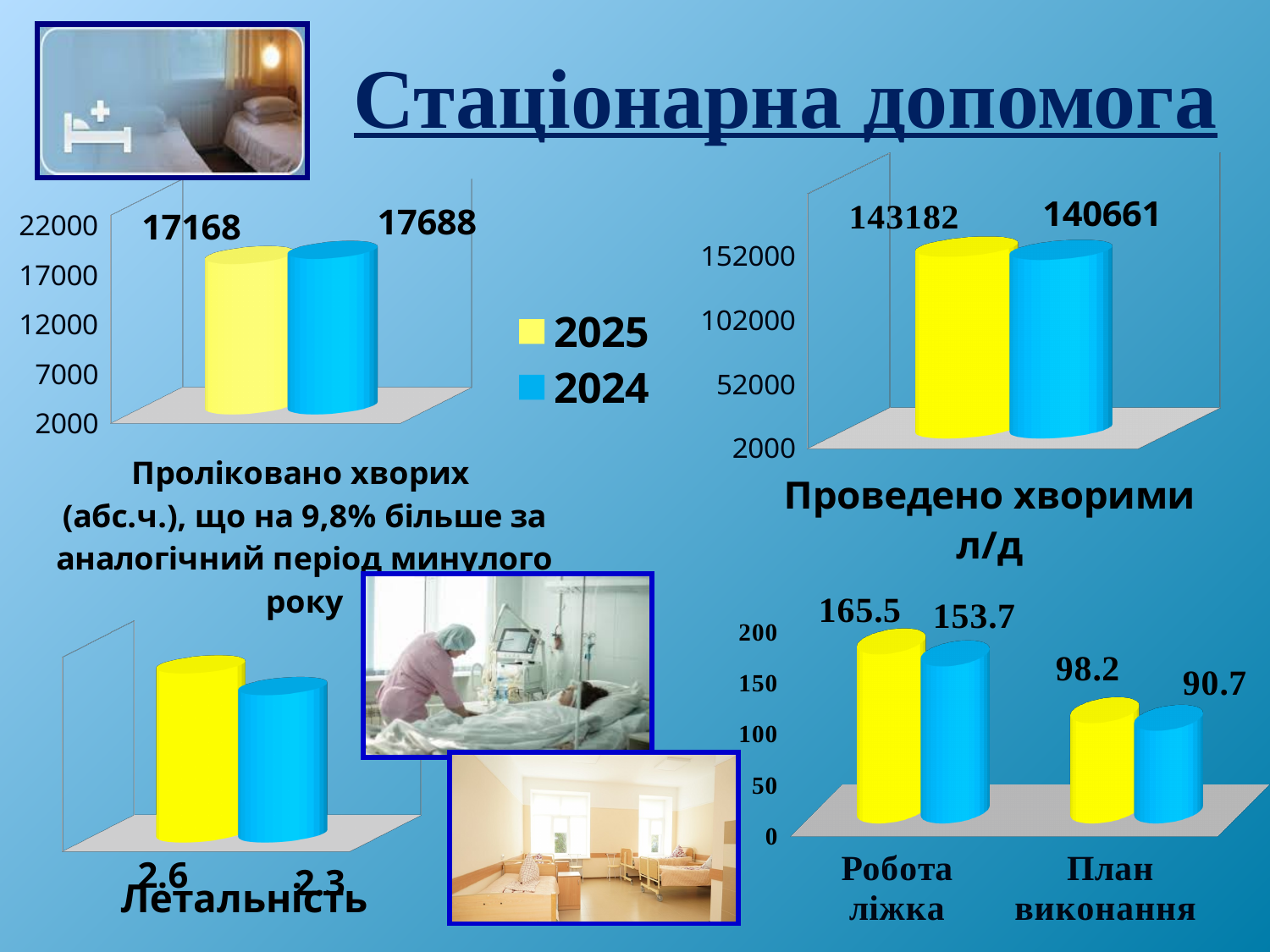
In the bottom-right chart, what is the difference between the 2025 and 2024 values for 'Робота ліжка'? 11.8 In the chart titled 'Проліковано хворих', what value is printed above the yellow bar? 17168 In the chart titled 'Проведено хворими л/д', what is the value for 2025? 143182 In the chart titled 'Проліковано хворих', what value is printed above the blue bar? 17688 In the chart titled 'Летальність', which year has the larger value, 2025 or 2024? 2025 In the chart titled 'Проведено хворими л/д', what is the difference between the 2025 and 2024 values? 2521 In the bottom-right chart, what is the 2024 value for 'План виконання'? 90.7 How many categories are shown on the x axis of the bottom-right chart? 2 In the bottom-right chart, what is the 2025 value for 'Робота ліжка'? 165.5 How many series does the legend on the slide list? 2 In the chart titled 'Летальність', what is the value for 2025? 2.6 In the chart titled 'Проведено хворими л/д', what is the value for 2024? 140661